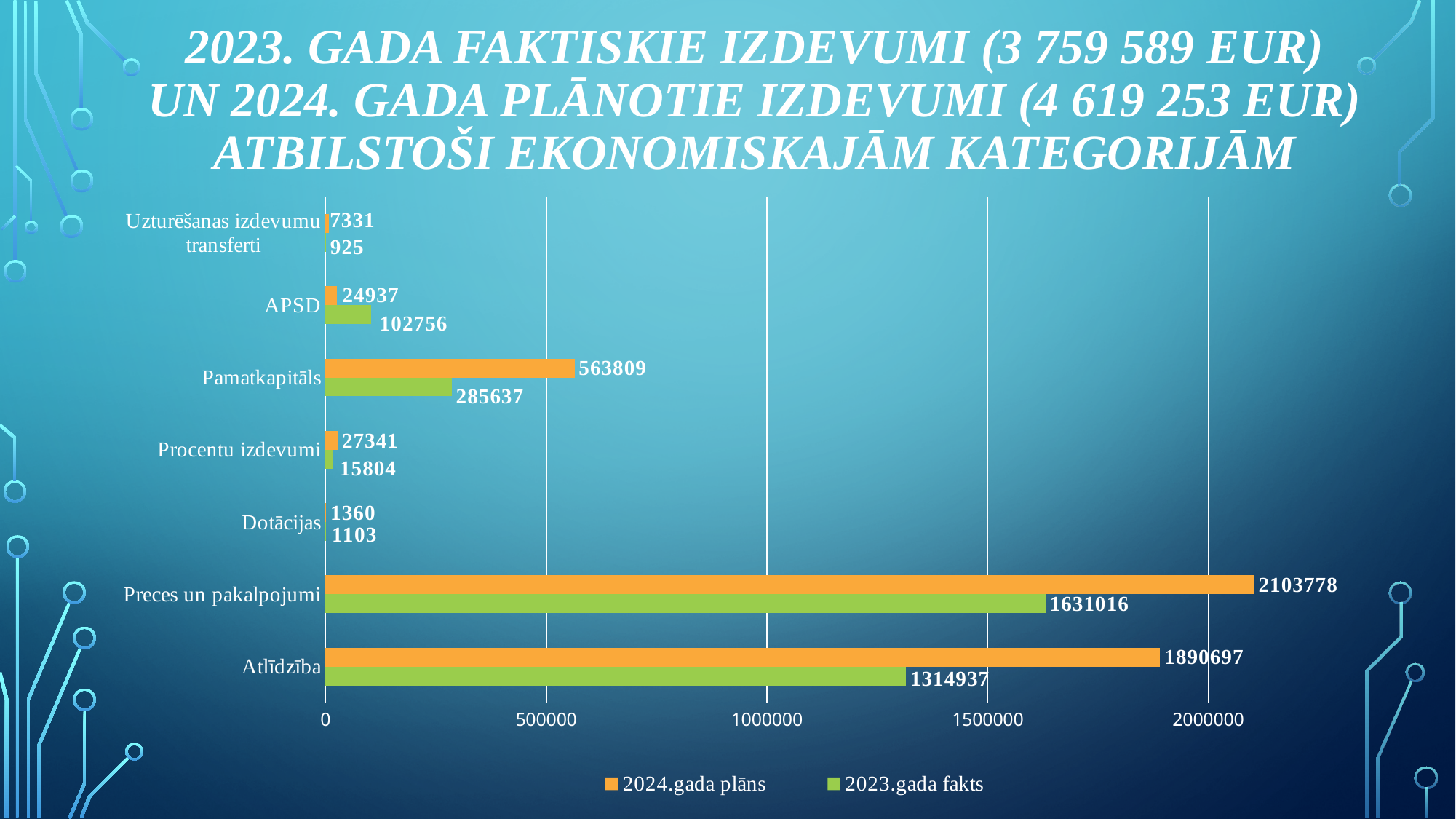
For APSD, which is larger: the 2024.gada plāns value or the 2023.gada fakts value? 2023.gada fakts Which category has the highest 2024.gada plāns value? Preces un pakalpojumi How many categories are shown on the chart? 7 Is the 2023.gada fakts value for Preces un pakalpojumi greater or less than 1500000? greater What is the difference between the 2024.gada plāns and 2023.gada fakts values for Atlīdzība? 575760 What is the 2023.gada fakts value for Atlīdzība? 1314937 What kind of chart is shown on the slide? bar chart What is the 2023.gada fakts value for APSD? 102756 What is the 2024.gada plāns value for Pamatkapitāls? 563809 How many series does the legend list? 2 Which category has the lowest 2023.gada fakts value? Uzturēšanas izdevumu transferti What is the 2024.gada plāns value for Preces un pakalpojumi? 2103778